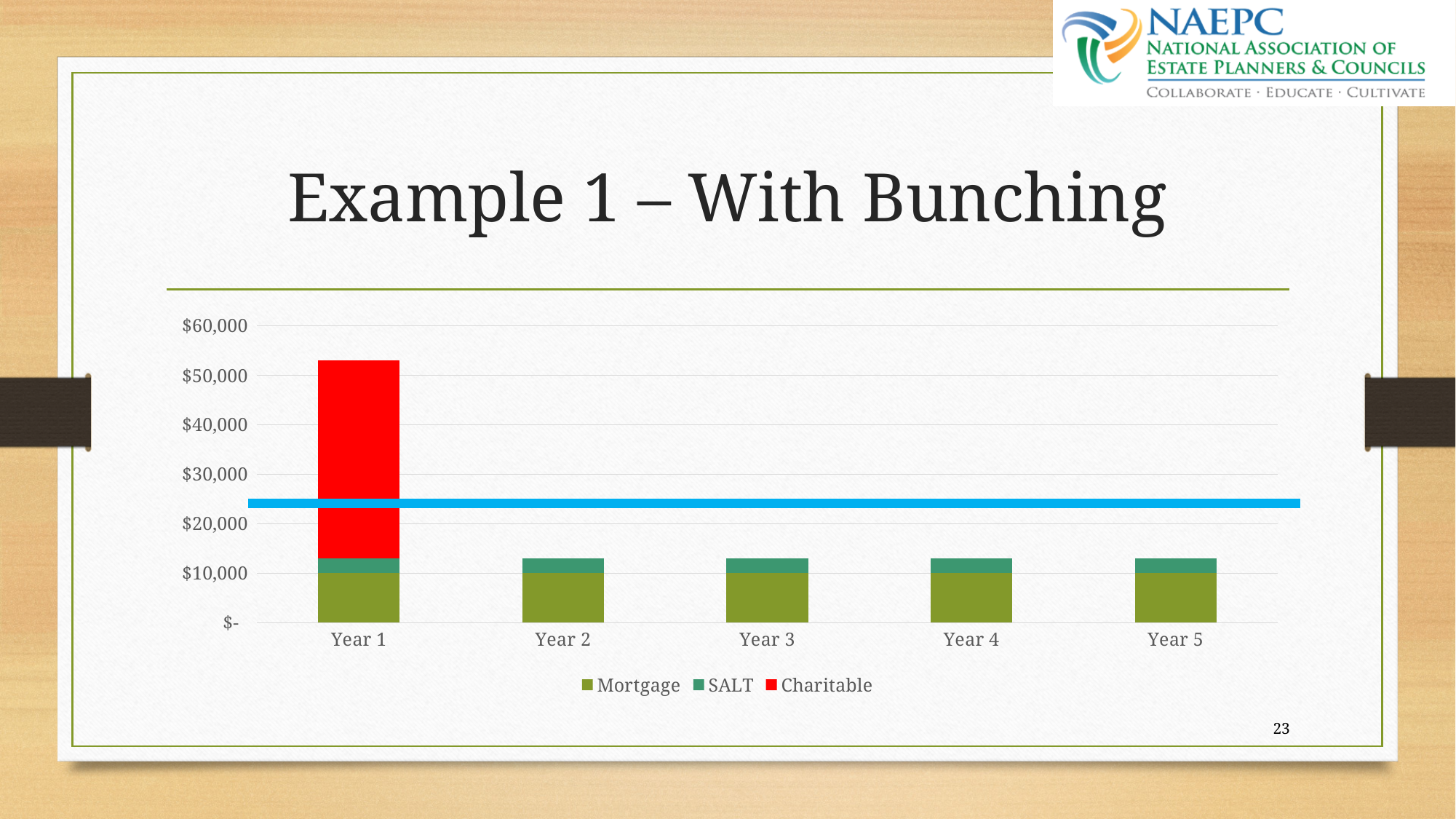
What kind of chart is shown on the slide? Stacked bar chart Which year has the highest total stacked bar? Year 1 What colour represents the Charitable series? Red Is the total for Year 1 greater or less than $50,000? greater What is the Mortgage value for Year 3? $10,000 Is the total for Year 2 greater or less than $20,000? less How many categories (years) are shown on the x axis? 5 How many series does the legend list? 3 In which year does the Charitable series appear? Year 1 What is the title of the slide containing the chart? Example 1 – With Bunching Which is larger, the total for Year 1 or the total for Year 4? Year 1 Is the Charitable value in Year 1 greater or less than $30,000? greater